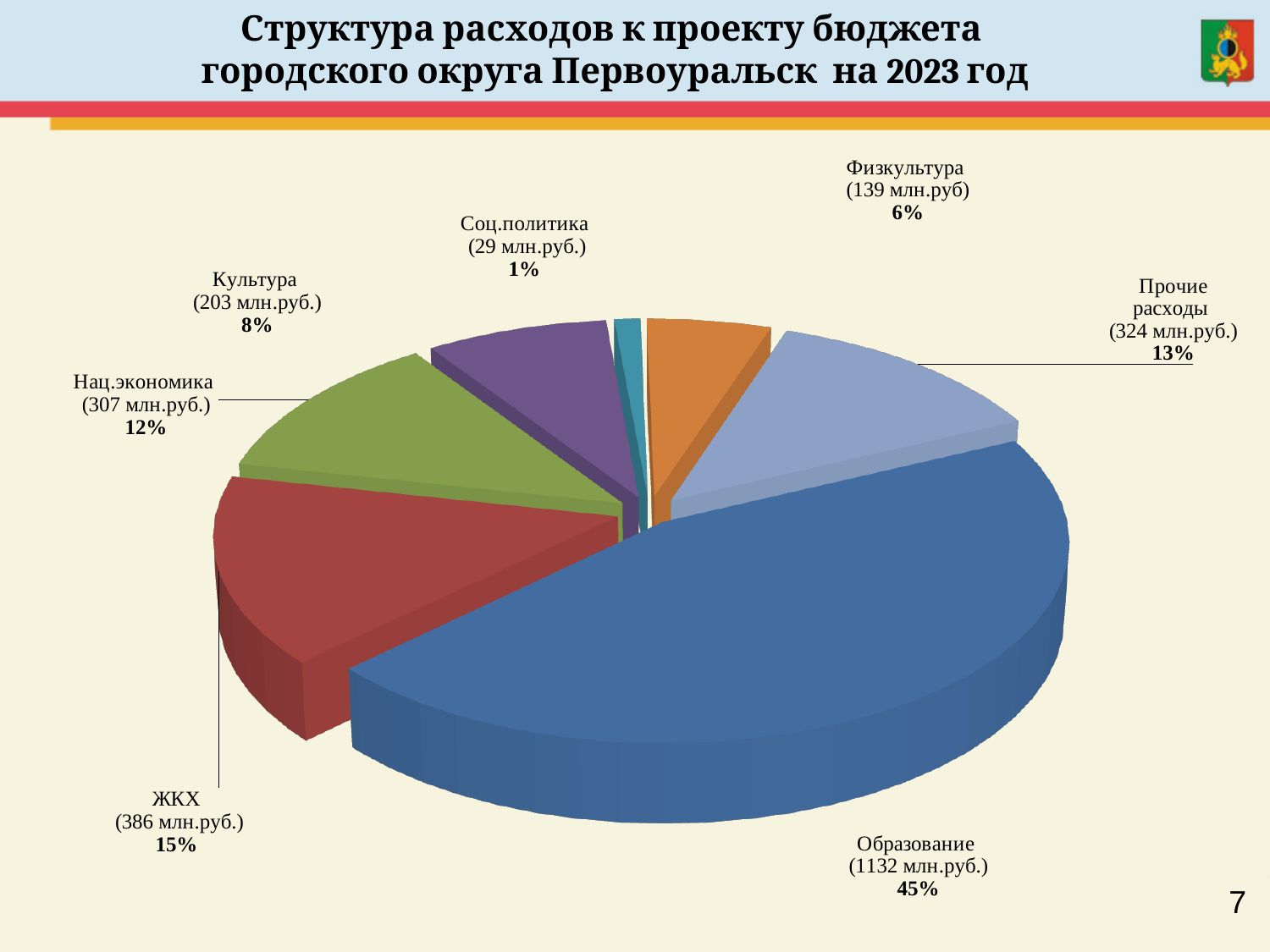
Which category has the smallest share of the pie? Соц.политика What is the value for Нац.экономика? 307 млн.руб. What share of the pie does ЖКХ take? 15% What share of the pie does Физкультура take? 6% What is the value for Соц.политика? 29 млн.руб. What kind of chart is shown on the slide? Pie chart What is the difference in млн.руб. between Прочие расходы and Культура? 121 млн.руб. What is the value for Образование? 1132 млн.руб. Which is larger, ЖКХ or Нац.экономика? ЖКХ Which category has the largest share of the pie? Образование What is the title of the chart? Структура расходов к проекту бюджета городского округа Первоуральск на 2023 год How many categories (slices) does the pie chart show? 7